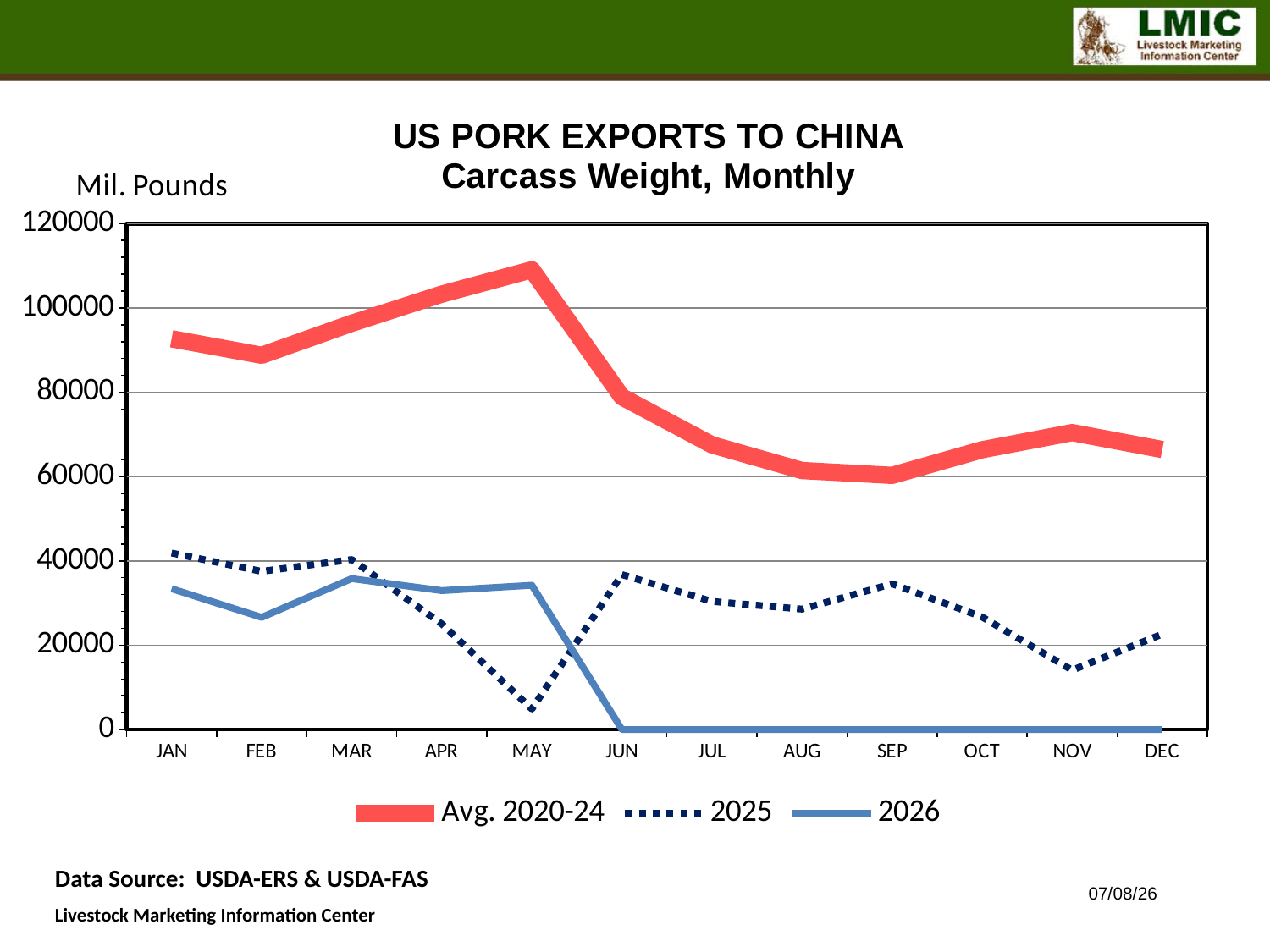
Which series has the larger value in JAN, Avg. 2020-24 or 2025? Avg. 2020-24 What unit is shown on the y axis of the chart? Mil. Pounds In which month does the Avg. 2020-24 series reach its highest value? MAY In which month does the 2025 series reach its lowest value? MAY How many months are shown along the x axis? 12 Is the value for 2025 in MAY greater or less than 20000? less Does the Avg. 2020-24 series rise or fall from MAY to SEP? fall How many series does the legend list? 3 What kind of chart is shown on the slide? line chart Is the value for 2026 in FEB greater or less than 40000? less In which month does the Avg. 2020-24 series reach its lowest value? SEP Is the value for Avg. 2020-24 in MAY greater or less than 100000? greater